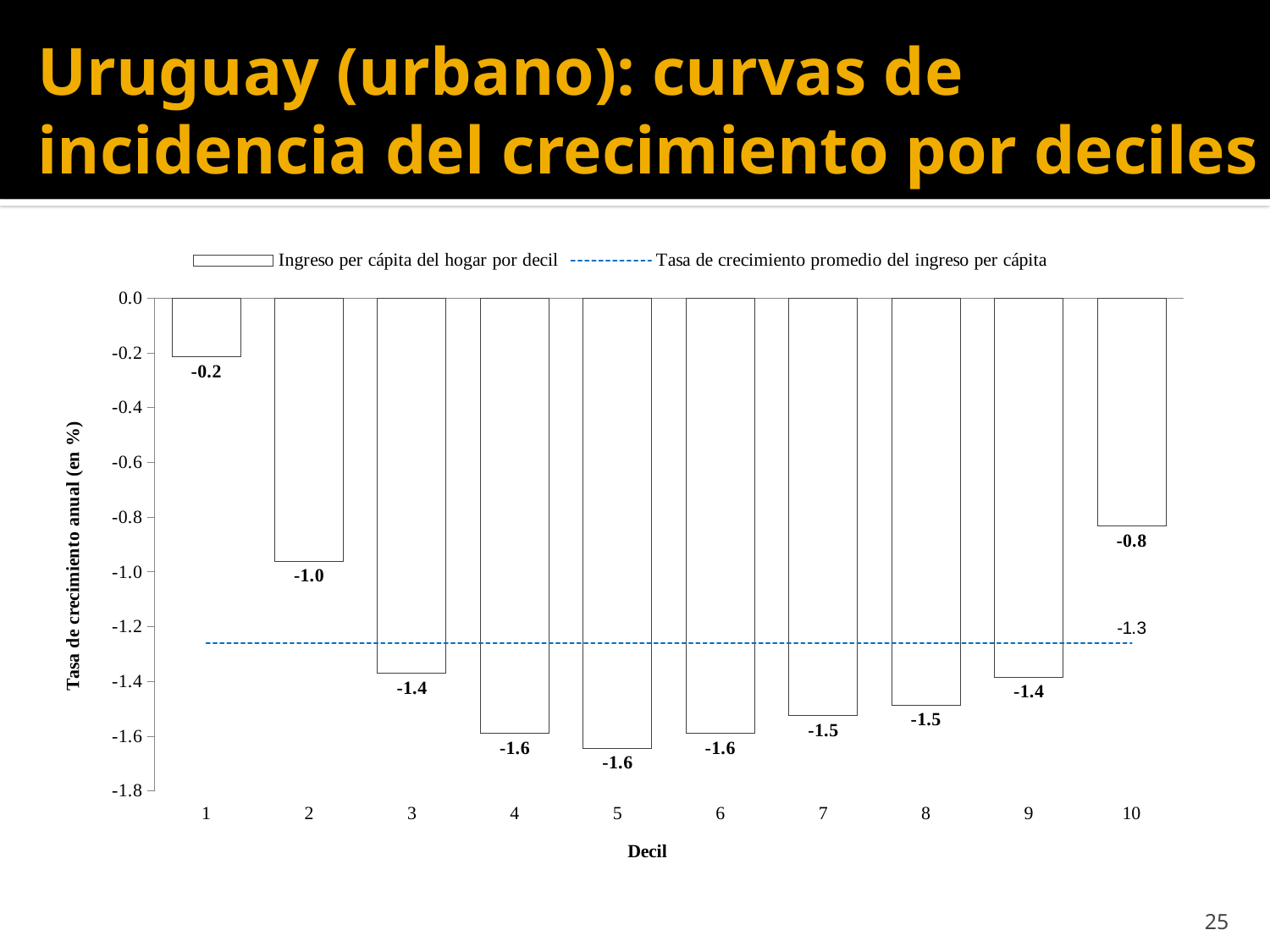
What is the value for decile 5? -1.6 What is the difference between the values for decile 1 and decile 10? 0.6 Is the value for decile 2 greater or less than -1.2? greater Which decile has the highest value? 1 What is the value for decile 1? -0.2 What is the value for decile 10? -0.8 What kind of chart is shown on the slide? Combination bar and line chart (bars with a dashed average line) From decile 6 to decile 10, do the values rise or fall? Rise What value is labelled on the dashed line for 'Tasa de crecimiento promedio del ingreso per cápita'? -1.3 How many deciles are shown on the x axis? 10 Which has the larger value, decile 2 or decile 9? Decile 2 How many series does the legend list? 2